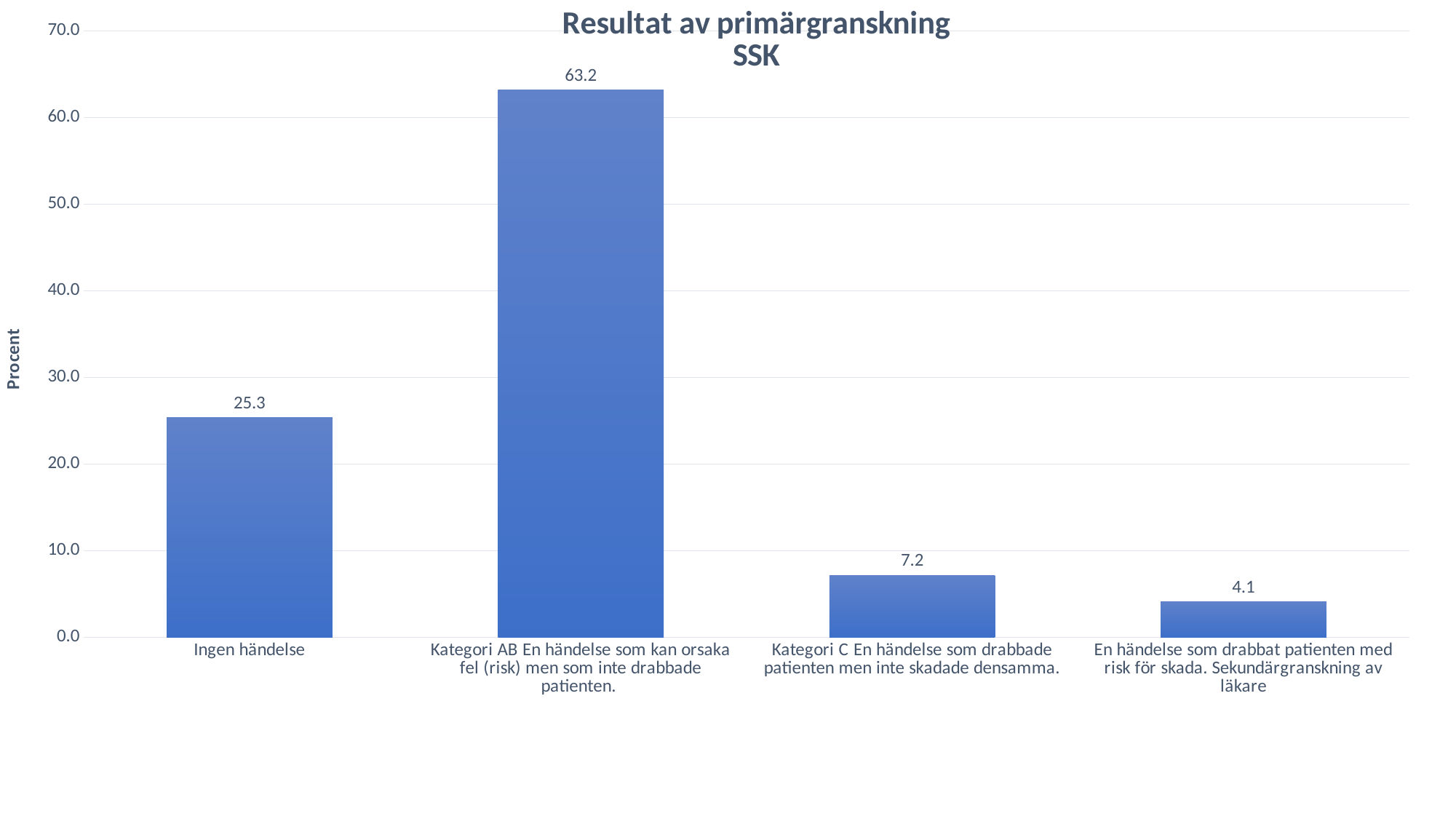
What is the value for the category 'En händelse som drabbat patienten med risk för skada. Sekundärgranskning av läkare'? 4.1 What is the value for Ingen händelse? 25.3 Which category has the highest value? Kategori AB En händelse som kan orsaka fel (risk) men som inte drabbade patienten. What is the value for Kategori AB (En händelse som kan orsaka fel (risk) men som inte drabbade patienten)? 63.2 How many categories are shown in the chart? 4 What is the title of the chart? Resultat av primärgranskning SSK What is the difference between the values for Kategori C and the category 'En händelse som drabbat patienten med risk för skada'? 3.1 What is the value for Kategori C (En händelse som drabbade patienten men inte skadade densamma)? 7.2 What is the difference between the values for Kategori AB and Ingen händelse? 37.9 Which is larger, the value for Ingen händelse or the value for Kategori C? Ingen händelse What kind of chart is shown on the slide? Bar chart Which category has the lowest value? En händelse som drabbat patienten med risk för skada. Sekundärgranskning av läkare